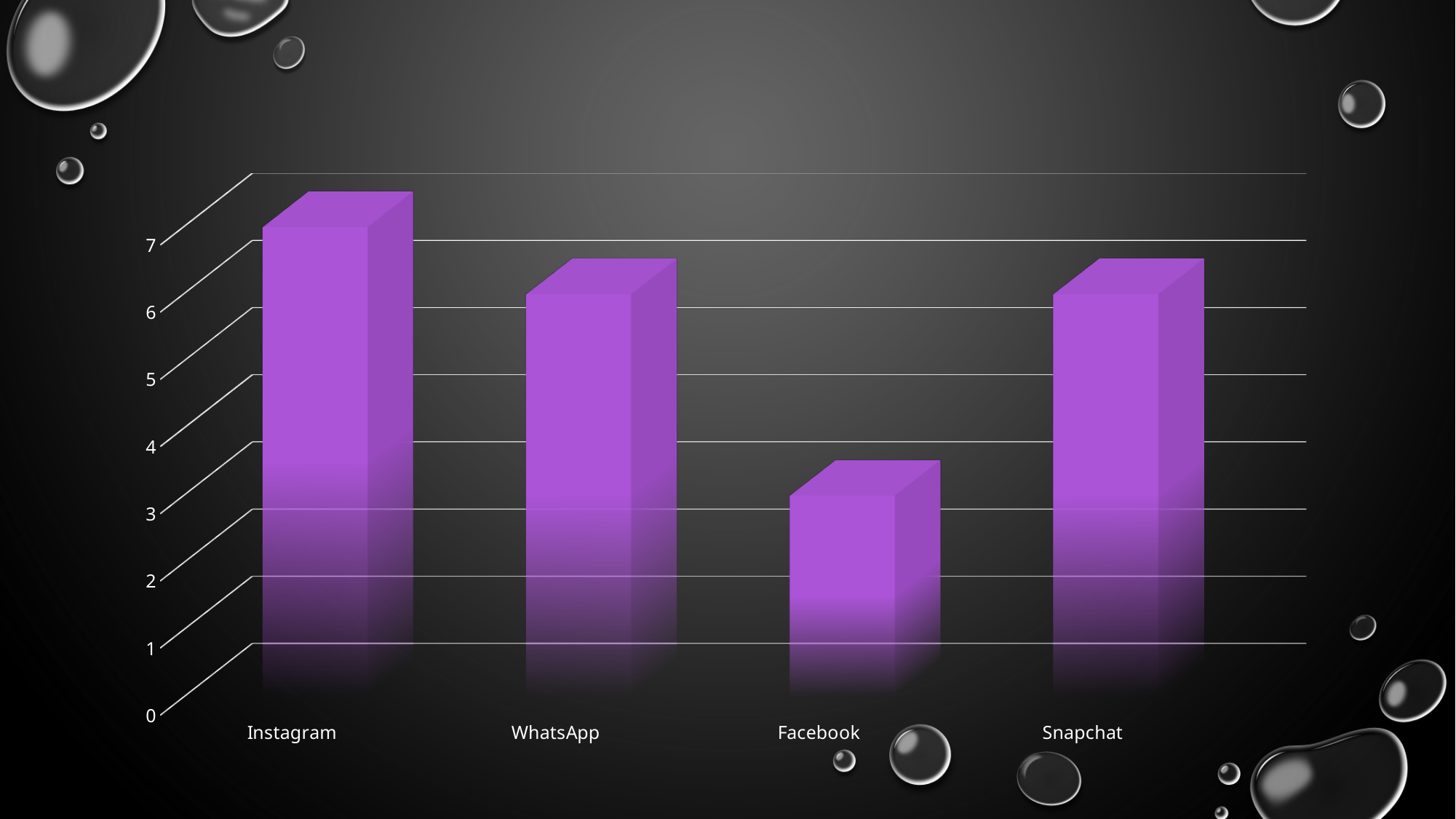
Which category has the highest bar in the chart? Instagram Which is larger, the value for Instagram or the value for Facebook? Instagram Is the value for WhatsApp greater or less than 4? greater What colour are the bars in the chart? purple Is the value for Snapchat greater or less than 4? greater What kind of chart is shown on the slide? bar chart How many categories are shown on the x axis of the chart? 4 Is the value for Facebook greater or less than 2? greater Which is larger, the value for WhatsApp or the value for Facebook? WhatsApp Which category has the lowest bar in the chart? Facebook